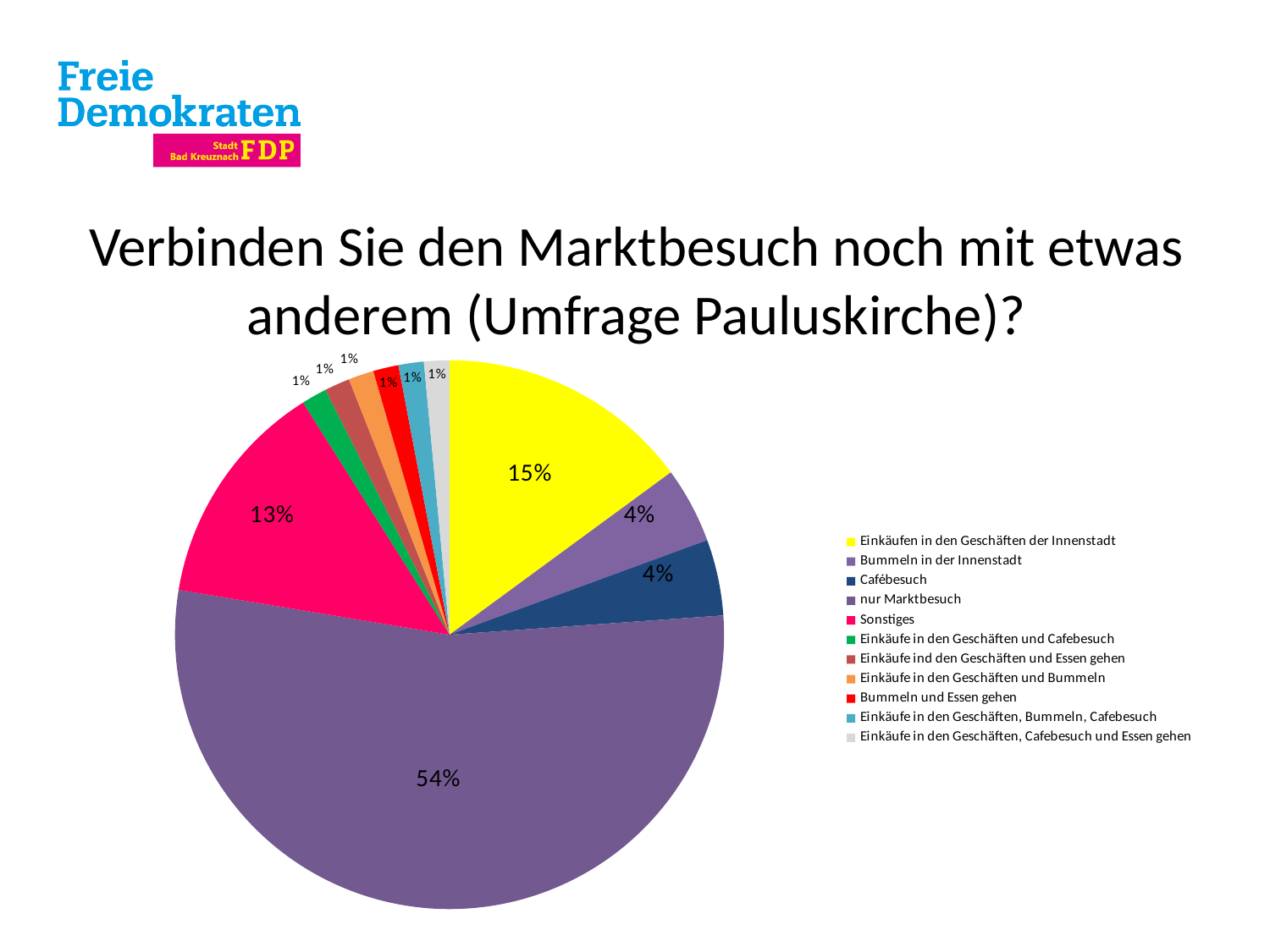
What share of the pie does "Sonstiges" have? 13% What share of the pie does "Bummeln in der Innenstadt" have? 4% What is the difference between the shares of "Einkäufen in den Geschäften der Innenstadt" and "Sonstiges"? 2% What is the difference between the shares of "nur Marktbesuch" and "Einkäufen in den Geschäften der Innenstadt"? 39% What colour is the slice for "Sonstiges"? pink What share of the pie does "Einkäufen in den Geschäften der Innenstadt" have? 15% How many categories does the legend of the pie chart list? 11 Which is larger, the share for "Sonstiges" or the share for "Cafébesuch"? Sonstiges What kind of chart is shown on the slide? pie chart Which category has the largest slice of the pie? nur Marktbesuch